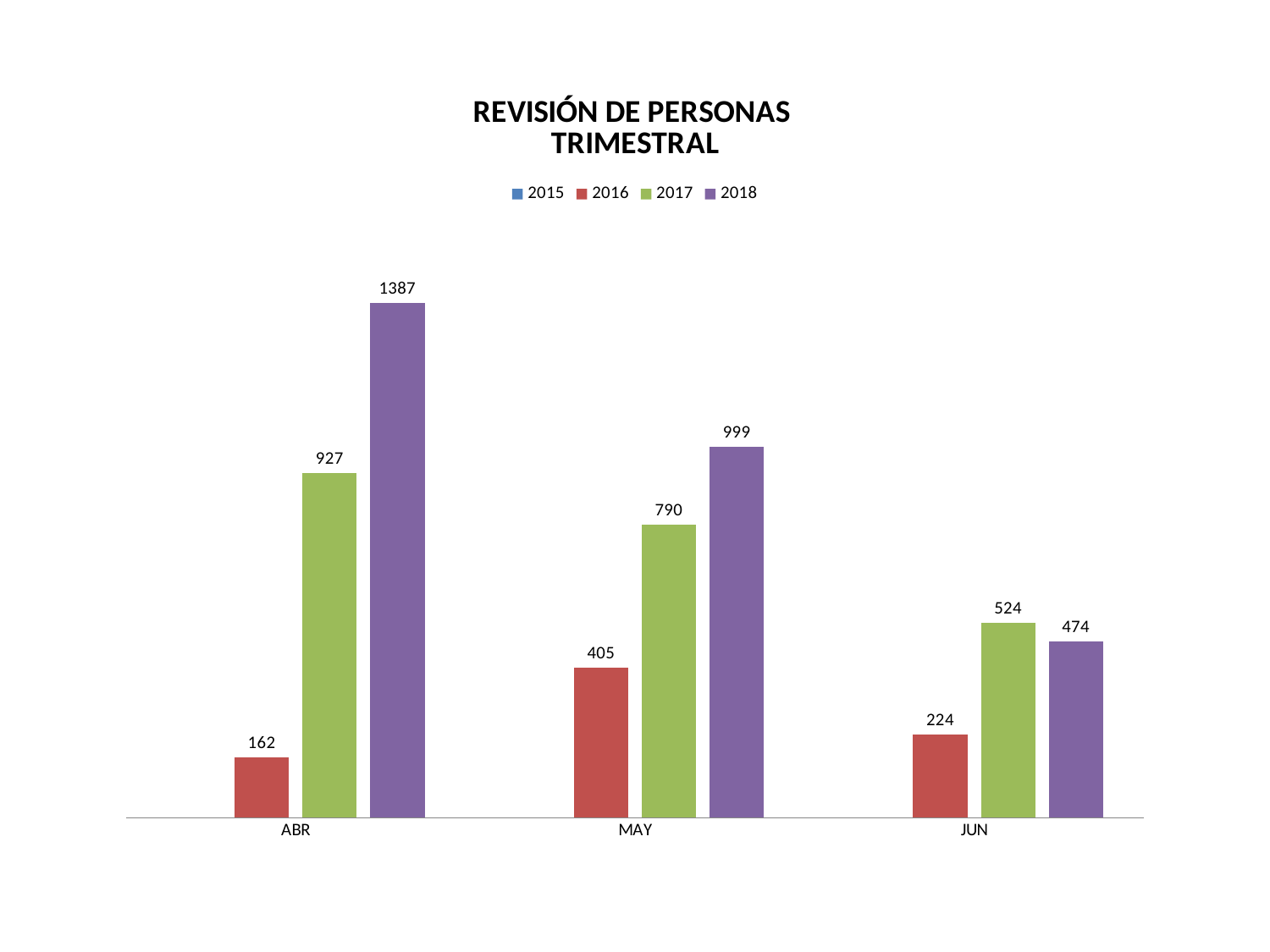
What is the difference between the 2018 and 2017 values in MAY? 209 What is the value for 2017 in JUN? 524 How many months are shown on the x axis? 3 What is the value for 2016 in MAY? 405 What kind of chart is this? Bar chart What is the title of the chart? REVISIÓN DE PERSONAS TRIMESTRAL How many series does the legend list? 4 Which is larger in JUN, the 2017 value or the 2018 value? 2017 Which month has the highest value for 2018? ABR Which month has the lowest value for 2016? ABR Do the 2017 values rise or fall from ABR to JUN? Fall What is the value for 2018 in ABR? 1387